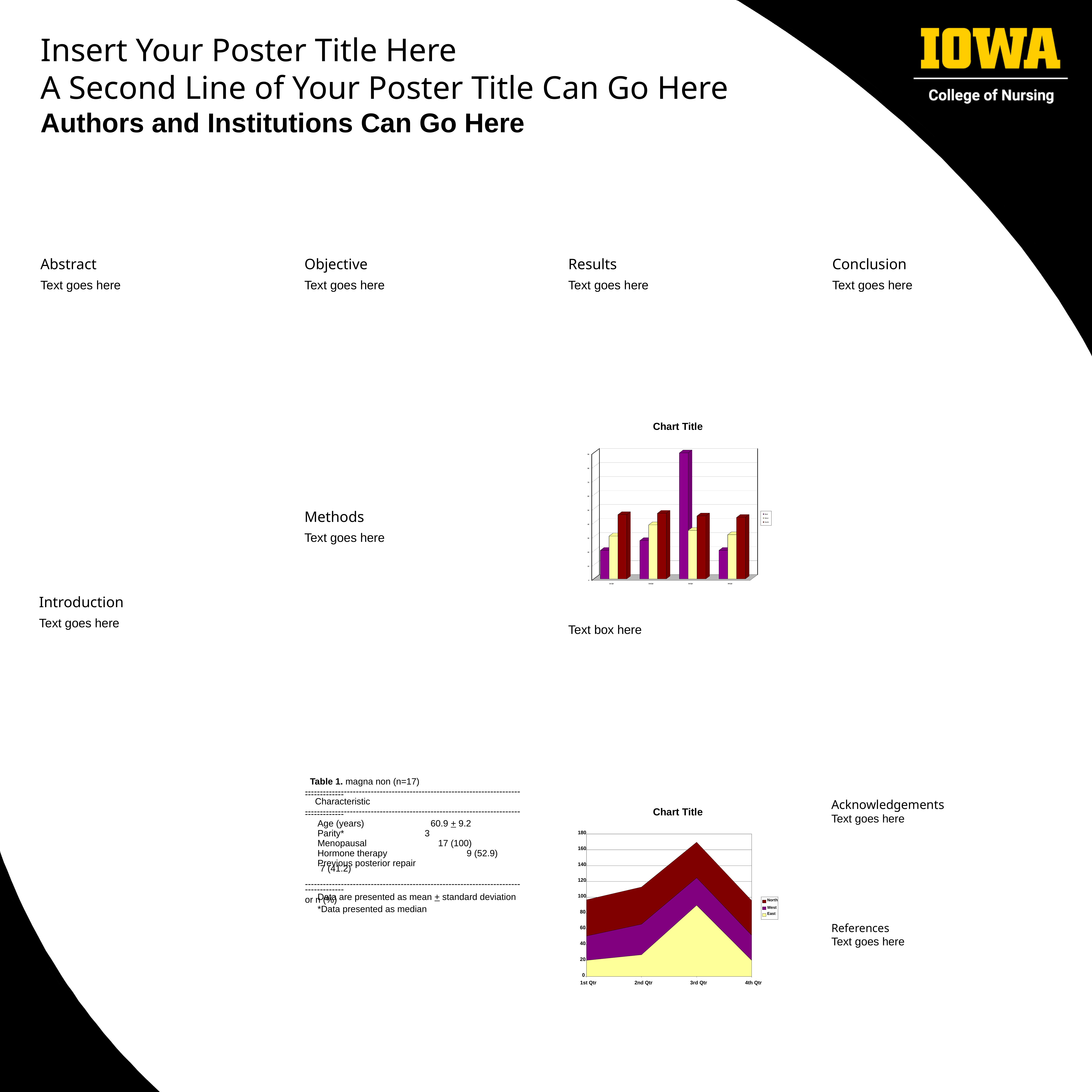
How many categories are shown on the x axis of the lower chart? 4 How many series does the legend of the lower chart list? 3 In the lower chart, which quarter has the highest value for East? 3rd Qtr What kind of chart is the lower chart on the slide? area chart In the lower chart, does the East series rise or fall from 1st Qtr to 3rd Qtr? rise In the lower chart, is the stacked total for 3rd Qtr greater or less than 140? greater What kind of chart is the upper chart on the slide? bar chart In the lower chart, is the value for East in 1st Qtr greater or less than 40? less In the lower chart, which quarter has the highest stacked total? 3rd Qtr In the lower chart, which series is shown in yellow? East In the lower chart, is the value for East in 3rd Qtr greater or less than 60? greater How many groups of bars does the upper chart show? 4